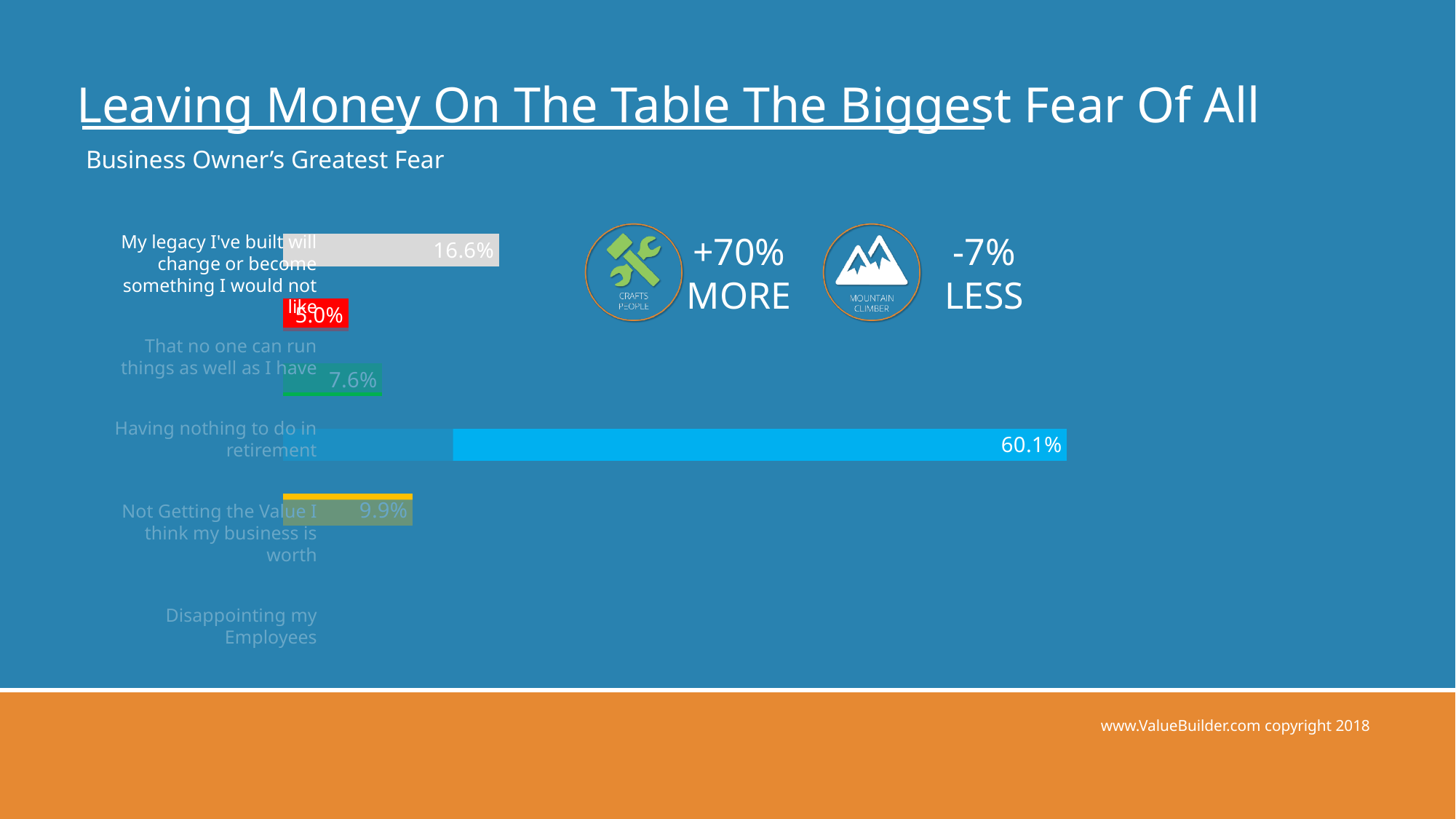
What kind of chart is shown on the slide? bar chart How many categories are listed on the chart's axis? 5 What colour is the longest bar on the chart? blue What is the largest value shown on the chart? 60.1% Which is larger, the 16.6% bar or the 9.9% bar? 16.6% What is the difference between the 9.9% bar and the 7.6% bar? 2.3% What is the smallest value shown on the chart? 5.0% What is the difference between the largest value (60.1%) and the second largest value (16.6%) on the chart? 43.5% What is the title of the chart? Business Owner's Greatest Fear How many bars on the chart have a data label above 10%? 2 What is the difference between the 16.6% bar and the 5.0% bar? 11.6%